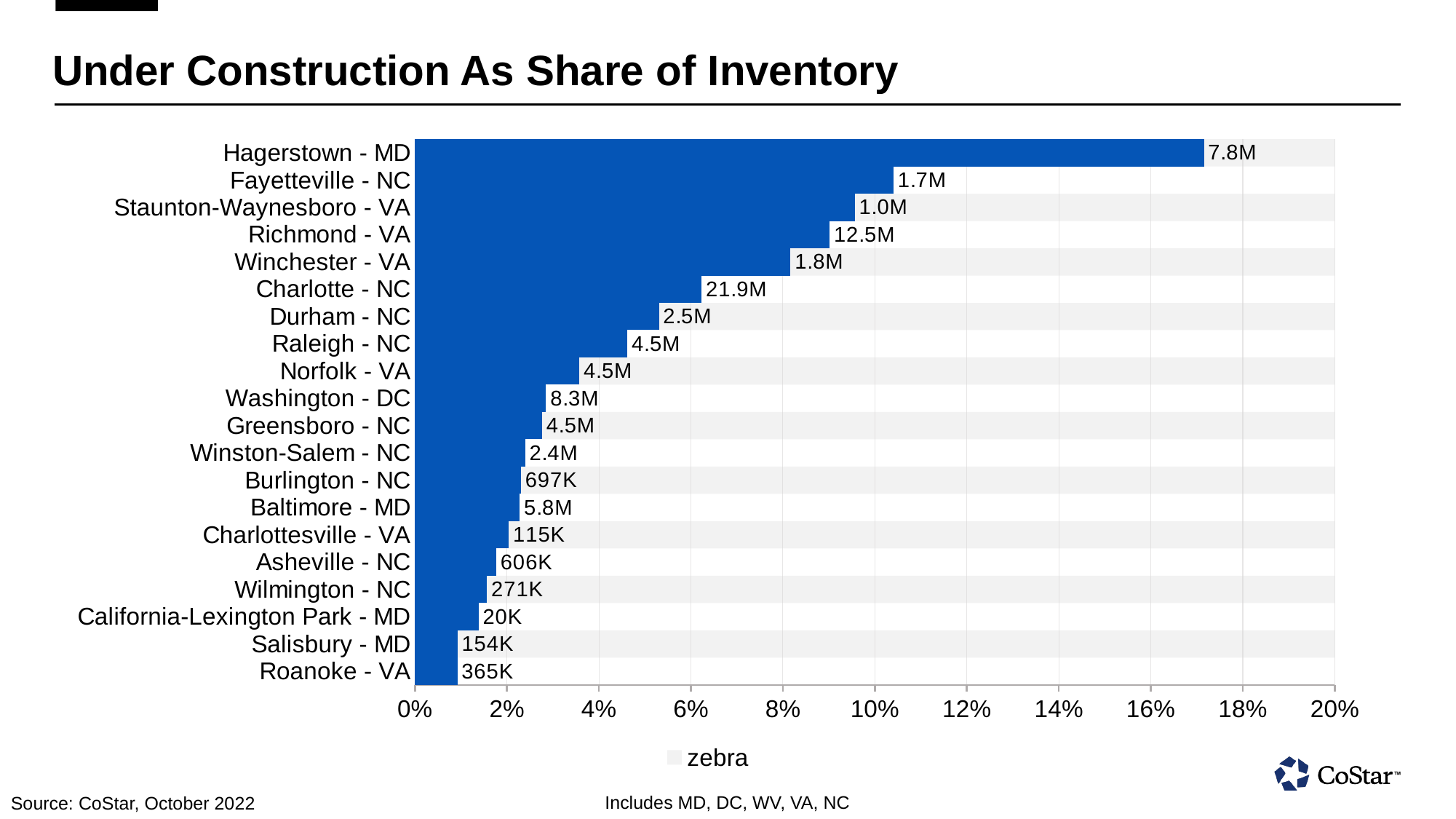
What data label is printed next to the bar for Charlotte - NC? 21.9M What data label is printed next to the bar for California-Lexington Park - MD? 20K What data label is printed next to the bar for Hagerstown - MD? 7.8M What kind of chart is shown on the slide? bar chart Is the under-construction share for Hagerstown - MD greater or less than 16%? greater Which market has the longest bar (highest under-construction share of inventory)? Hagerstown - MD Is the under-construction share for Washington - DC greater or less than 4%? less What is the single entry shown in the chart legend? zebra Which has the larger under-construction share of inventory, Charlotte - NC or Raleigh - NC? Charlotte - NC Is the under-construction share for Roanoke - VA greater or less than 2%? less How many markets are listed on the chart? 20